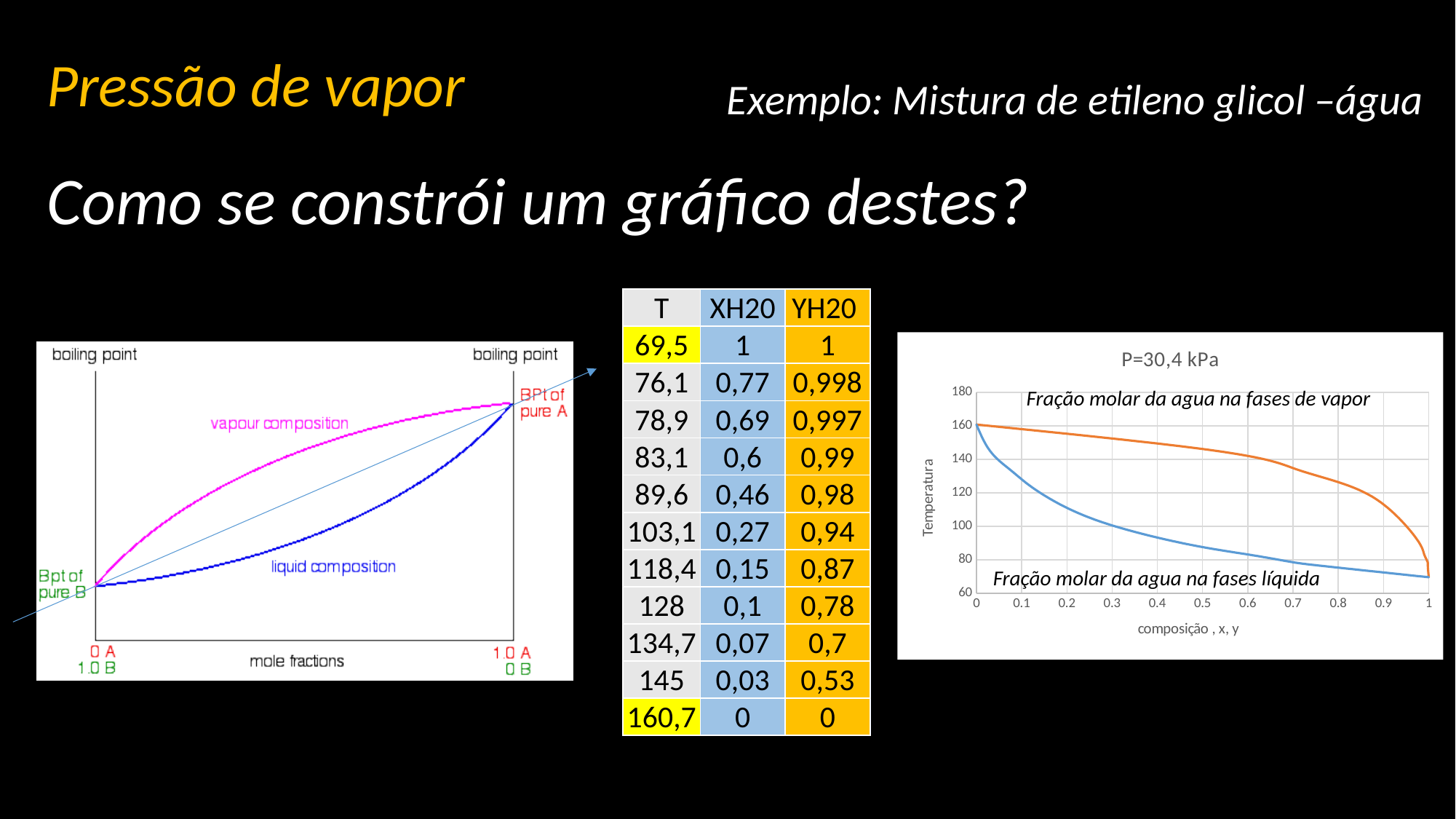
In the chart titled "P=30,4 kPa", which curve shows the higher temperature at composition 0.5, the vapor-phase curve or the liquid-phase curve? vapor-phase curve In the chart on the left of the slide, which curve lies higher, the vapour composition curve or the liquid composition curve? vapour composition What kind of chart is the chart on the left of the slide showing boiling point against mole fractions? line chart In the chart titled "P=30,4 kPa", how many data series are plotted? 2 In the chart on the left of the slide, does the boiling point rise or fall as the mole fraction of A increases from 0 to 1.0? rise In the chart titled "P=30,4 kPa", does the temperature rise or fall as the composition increases from 0 to 1? fall What is the title of the chart on the right of the slide? P=30,4 kPa What is the label of the x axis of the chart on the left of the slide? mole fractions What kind of chart is the chart on the right titled "P=30,4 kPa"? line chart In the chart titled "P=30,4 kPa", is the temperature of the vapor-phase curve (orange) at composition 0.5 greater or less than 140? greater In the chart titled "P=30,4 kPa", is the temperature of the liquid-phase curve (blue) at composition 0.5 greater or less than 100? less In the chart titled "P=30,4 kPa", is the temperature of the liquid-phase curve (blue) at composition 0.2 greater or less than 120? less